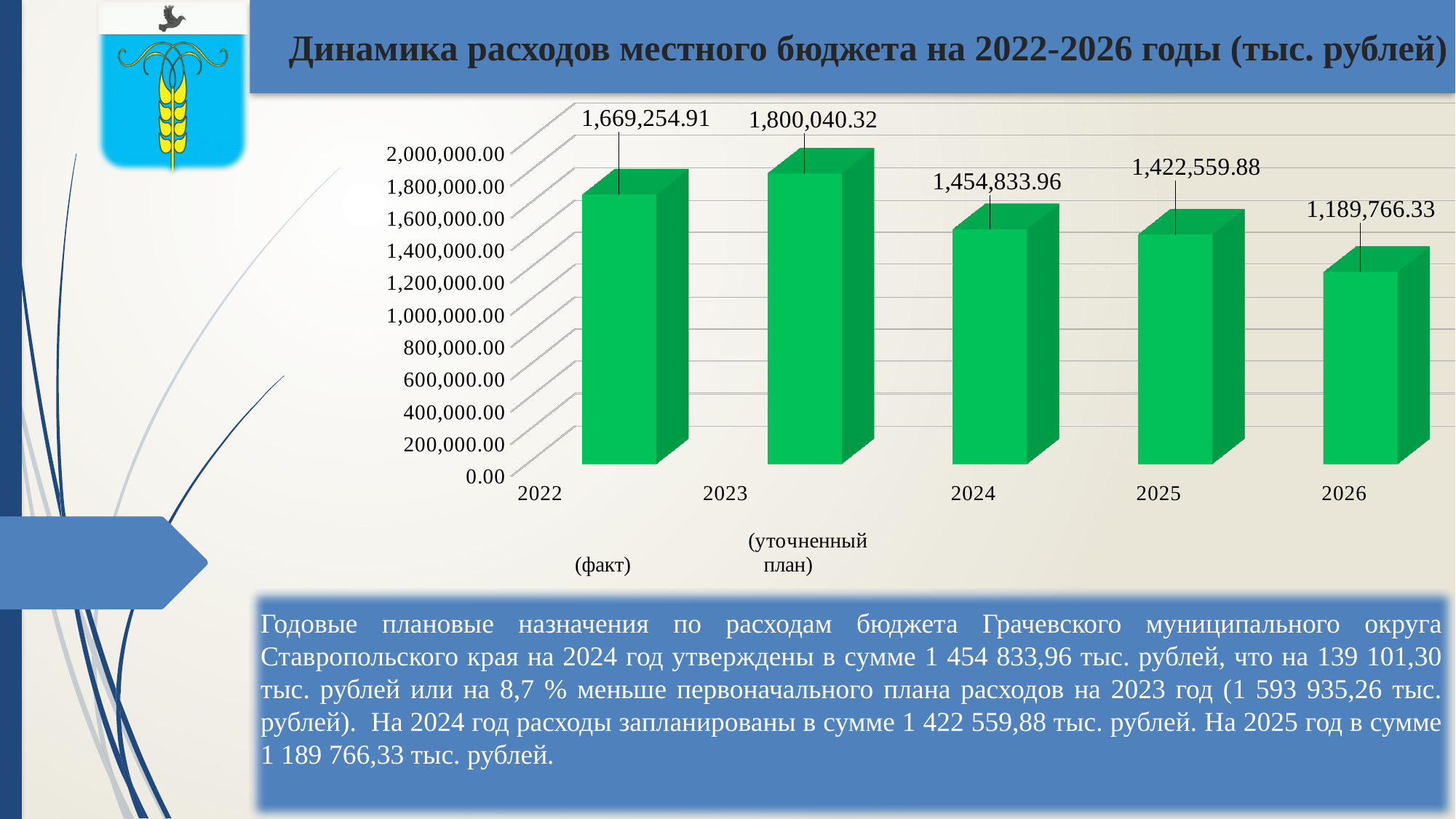
What kind of chart is shown on the slide? bar chart Which is larger, the value for 2024 or the value for 2025? 2024 What is the value for 2026? 1,189,766.33 Which year has the highest value? 2023 From 2023 to 2026, do the values rise or fall? fall What is the difference between the values for 2023 and 2022? 130,785.41 What is the difference between the values for 2025 and 2026? 232,793.55 What is the value for 2024? 1,454,833.96 How many years are shown on the x axis? 5 Which year has the lowest value? 2026 What is the value for 2022 (факт)? 1,669,254.91 What is the value for 2023 (уточненный план)? 1,800,040.32